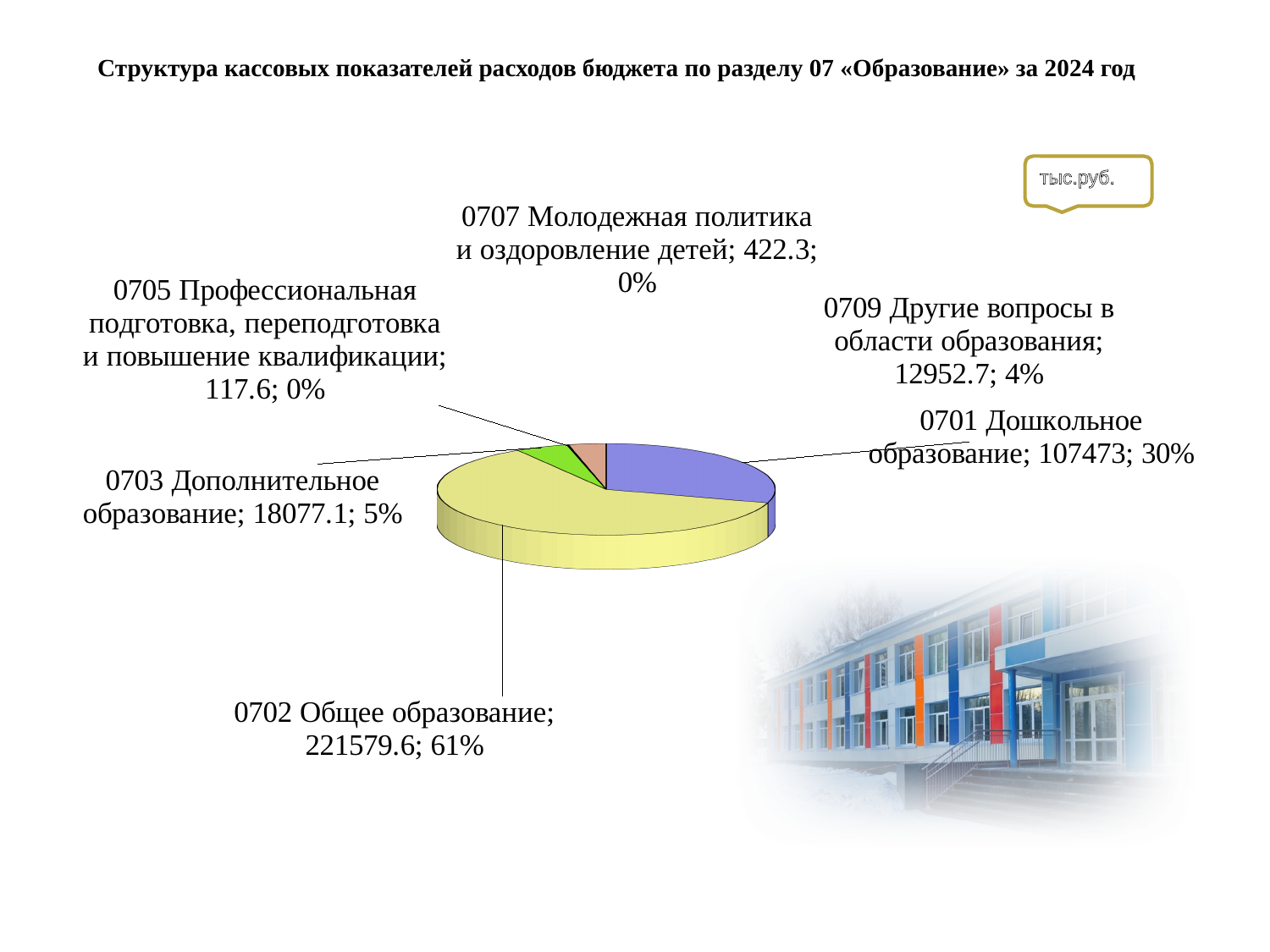
Which category has the smallest value? 0705 Профессиональная подготовка, переподготовка и повышение квалификации What share of the pie does 0703 Дополнительное образование represent? 5% What is the value for 0701 Дошкольное образование? 107473 What is the value for 0702 Общее образование? 221579.6 How many categories (slices) does the pie chart show? 6 What is the value for 0709 Другие вопросы в области образования? 12952.7 What is the difference between the values for 0702 Общее образование and 0701 Дошкольное образование? 114106.6 What type of chart is shown on the slide? Pie chart Which category has the largest value? 0702 Общее образование Which is larger: the value for 0703 Дополнительное образование or 0709 Другие вопросы в области образования? 0703 Дополнительное образование What unit of measurement is indicated in the box at the top right of the chart? тыс.руб. What share of the pie does 0702 Общее образование represent? 61%